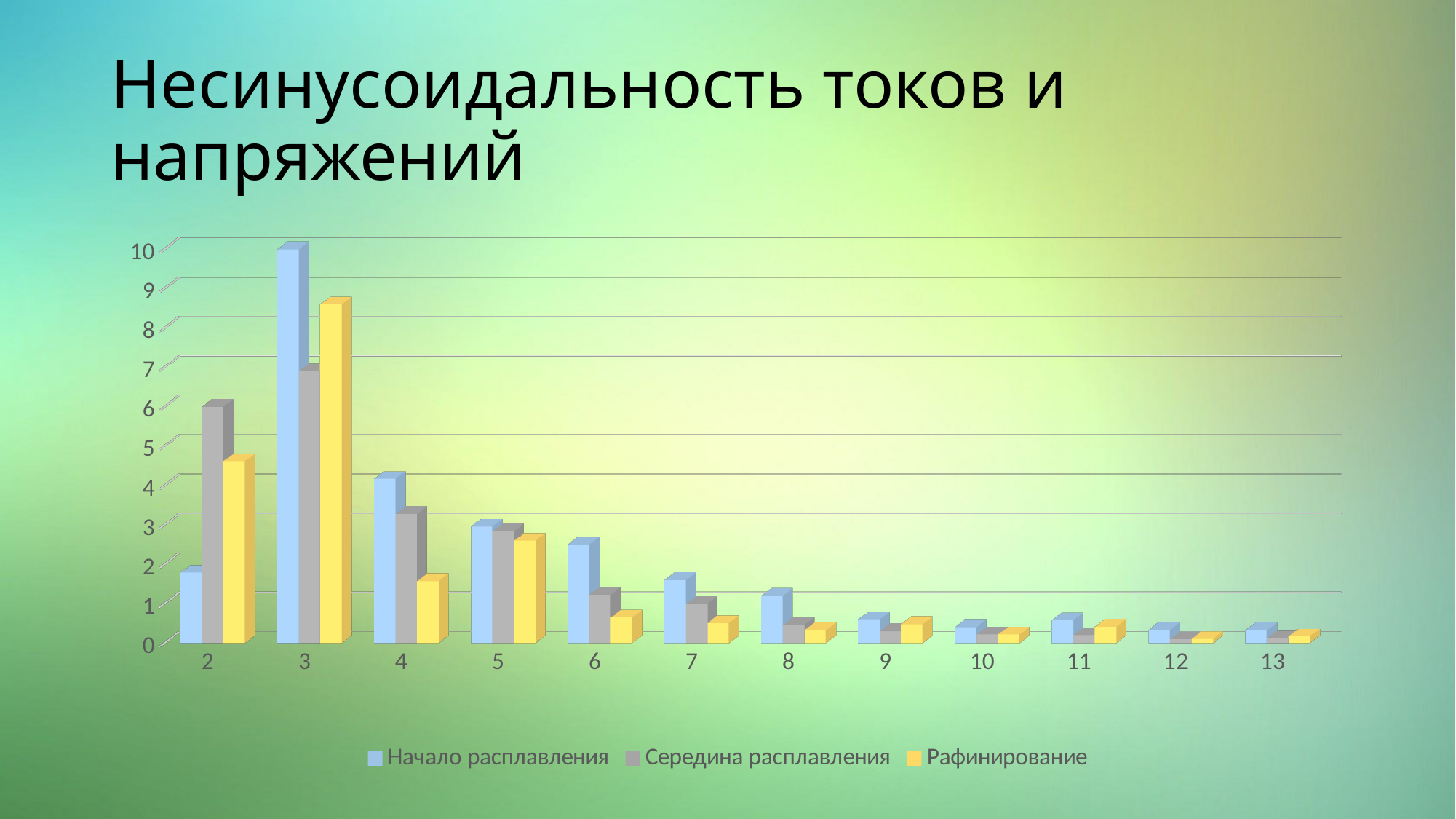
At category 4, which is larger: Начало расплавления or Рафинирование? Начало расплавления Do the values for Начало расплавления rise or fall from category 3 to category 13? fall Is the value for Рафинирование at category 4 greater or less than 2? less How many categories are shown on the x axis of the chart? 12 Is the value for Начало расплавления at category 3 greater or less than 8? greater Which colour represents the Рафинирование series in the chart? yellow At category 3, which is larger: Начало расплавления or Середина расплавления? Начало расплавления Which series has the highest value at category 2? Середина расплавления How many series does the chart legend list? 3 What kind of chart is shown on the slide? bar chart Which category has the highest value for Начало расплавления? 3 Which category has the highest value for Рафинирование? 3